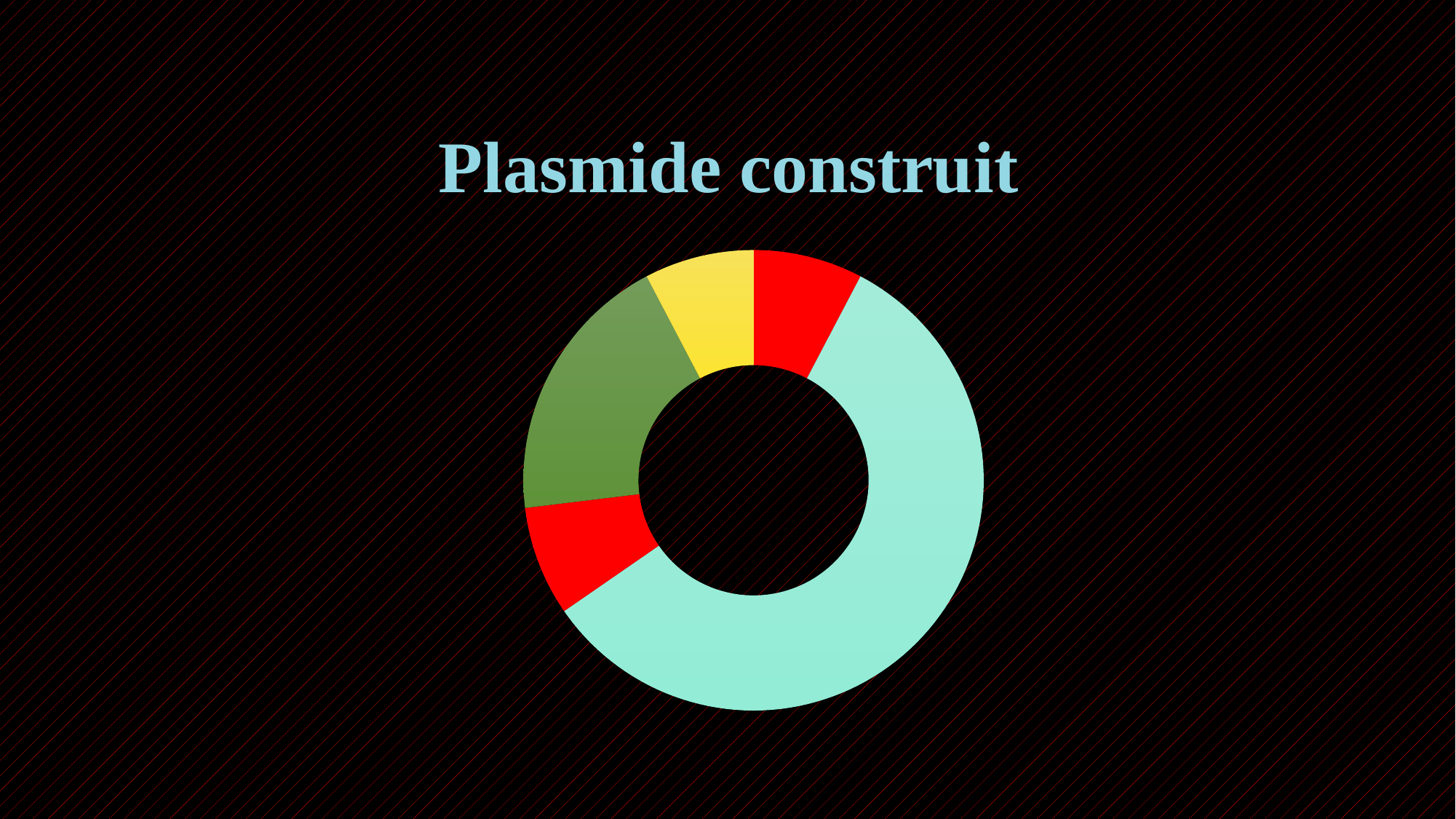
What kind of chart is shown on the slide? doughnut chart Which colour segment takes up the largest share of the doughnut? light cyan Which is larger, the green segment or the yellow segment? green Does the light cyan segment cover more or less than half of the doughnut? more Does the chart display a legend? No How many segments does the doughnut chart have? 5 What is the title of the chart? Plasmide construit Which is larger, the light cyan segment or the green segment? light cyan